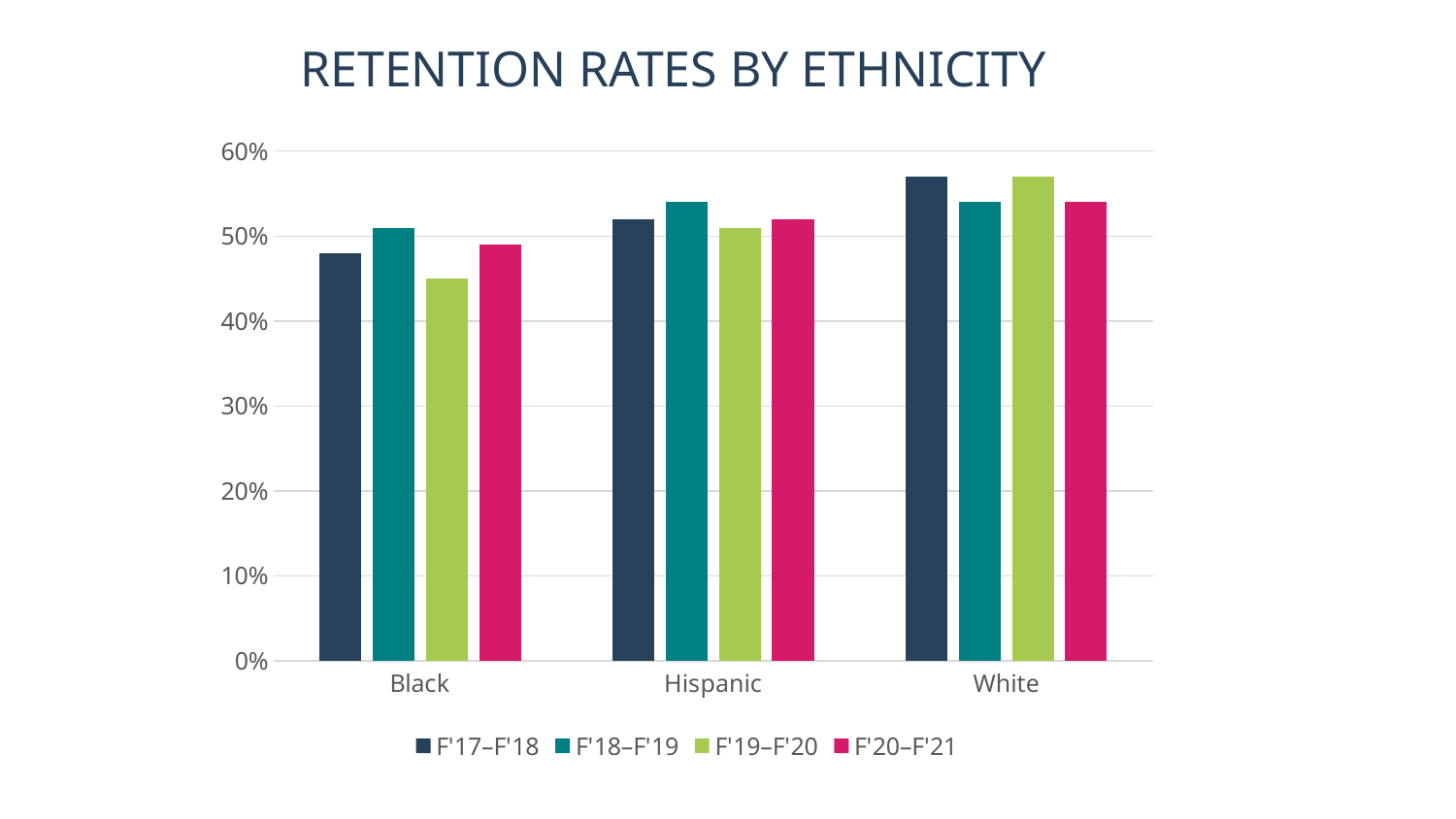
Is the F'19–F'20 retention rate for Black students greater or less than 50%? less For the F'19–F'20 series, which group has the larger retention rate, Black or White? White What is the title of the chart? RETENTION RATES BY ETHNICITY How many series does the legend list? 4 Is the F'18–F'19 retention rate for Black students greater or less than 50%? greater Which series has the highest retention rate for Hispanic students? F'18–F'19 How many ethnicity categories are shown on the x axis? 3 Which series has the lowest retention rate for Black students? F'19–F'20 Is the F'17–F'18 retention rate for White students greater or less than 50%? greater Which legend entry is shown in pink? F'20–F'21 What kind of chart is shown on the slide? Bar chart